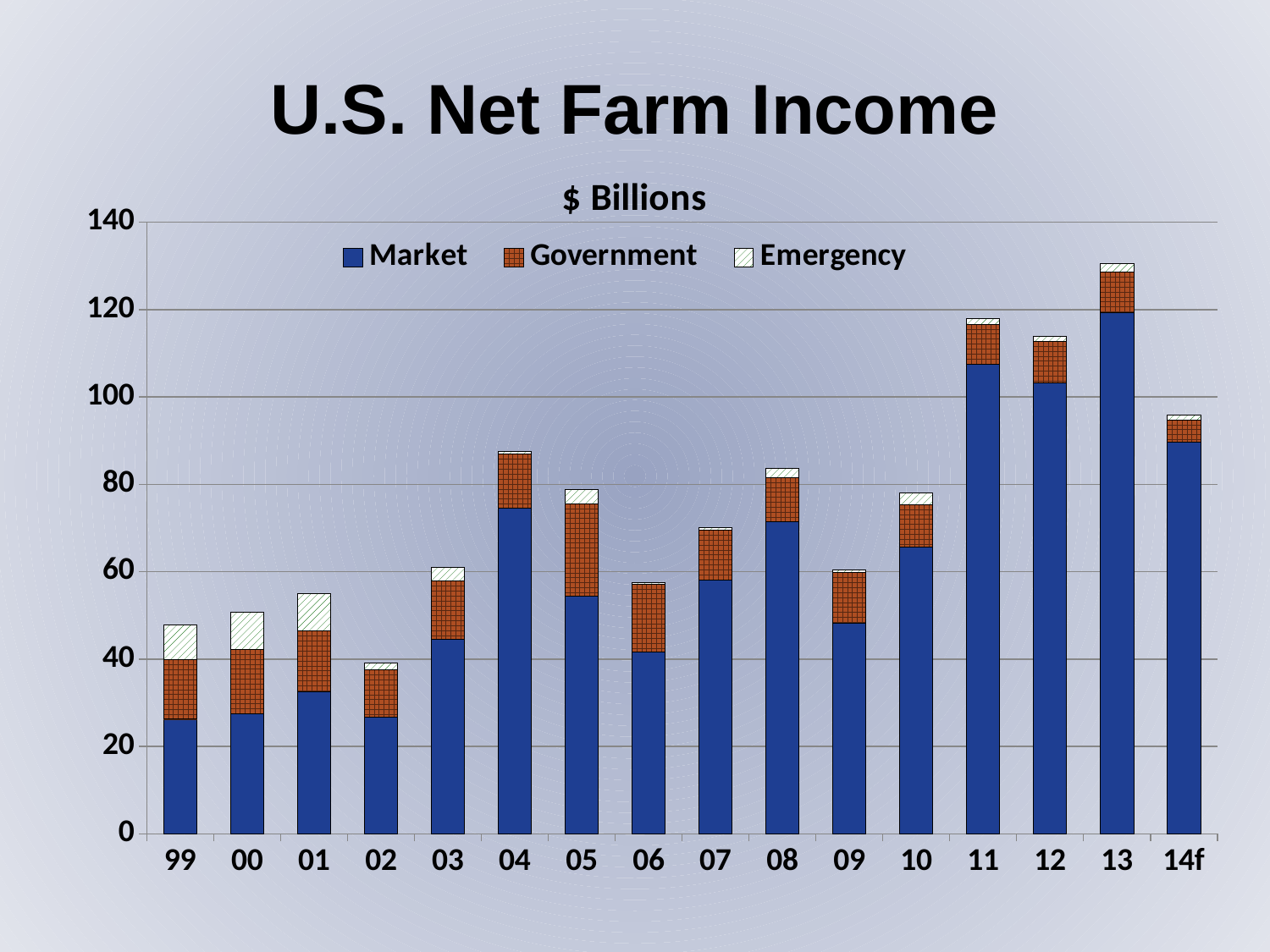
How many series does the legend list? 3 What unit is given in the chart's subtitle? $ Billions Is the total bar for 99 greater or less than 60? less Is the Market segment for 11 greater or less than 100? greater Which year has the highest total net farm income bar? 13 Which year has the lowest total net farm income bar? 02 What kind of chart is shown on the slide? Stacked bar chart Is the total bar for 13 greater or less than 120? greater Which year has the larger total bar, 08 or 09? 08 Do the total bars rise or fall from 10 to 13? rise How many years (categories) are shown on the x axis? 16 Which year has the larger Market segment, 05 or 06? 05